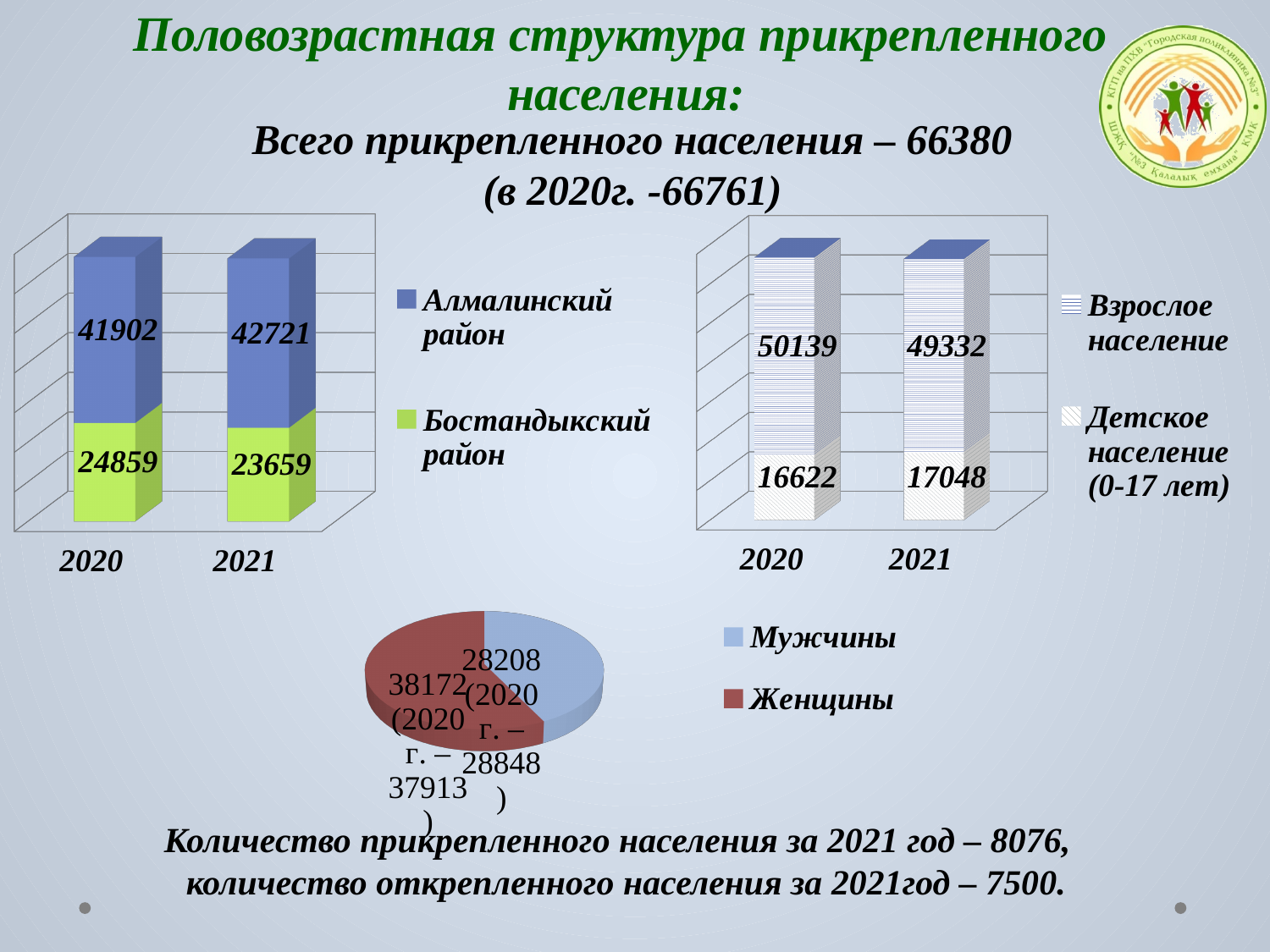
In the bottom pie chart, which category is larger, Мужчины or Женщины? Женщины What kind of chart is the bottom chart showing Мужчины and Женщины? pie chart In the top-right bar chart, what is the total of the stacked bar for 2021? 66380 In the top-right bar chart, did the value for Взрослое население rise or fall from 2020 to 2021? fall In the top-left bar chart, what is the total of the stacked bar for 2020? 66761 In the top-left bar chart, by how much did the value for Бостандыкский район change from 2020 to 2021? 1200 In the top-right bar chart, what is the value for Взрослое население in 2020? 50139 In the top-left bar chart, what is the value for Алмалинский район in 2021? 42721 In the bottom pie chart, what is the 2020 value shown for Мужчины? 28848 In the top-right bar chart, what is the value for Детское население (0-17 лет) in 2021? 17048 In the top-left bar chart, what is the value for Бостандыкский район in 2020? 24859 In the top-left bar chart, how many series does the legend list? 2